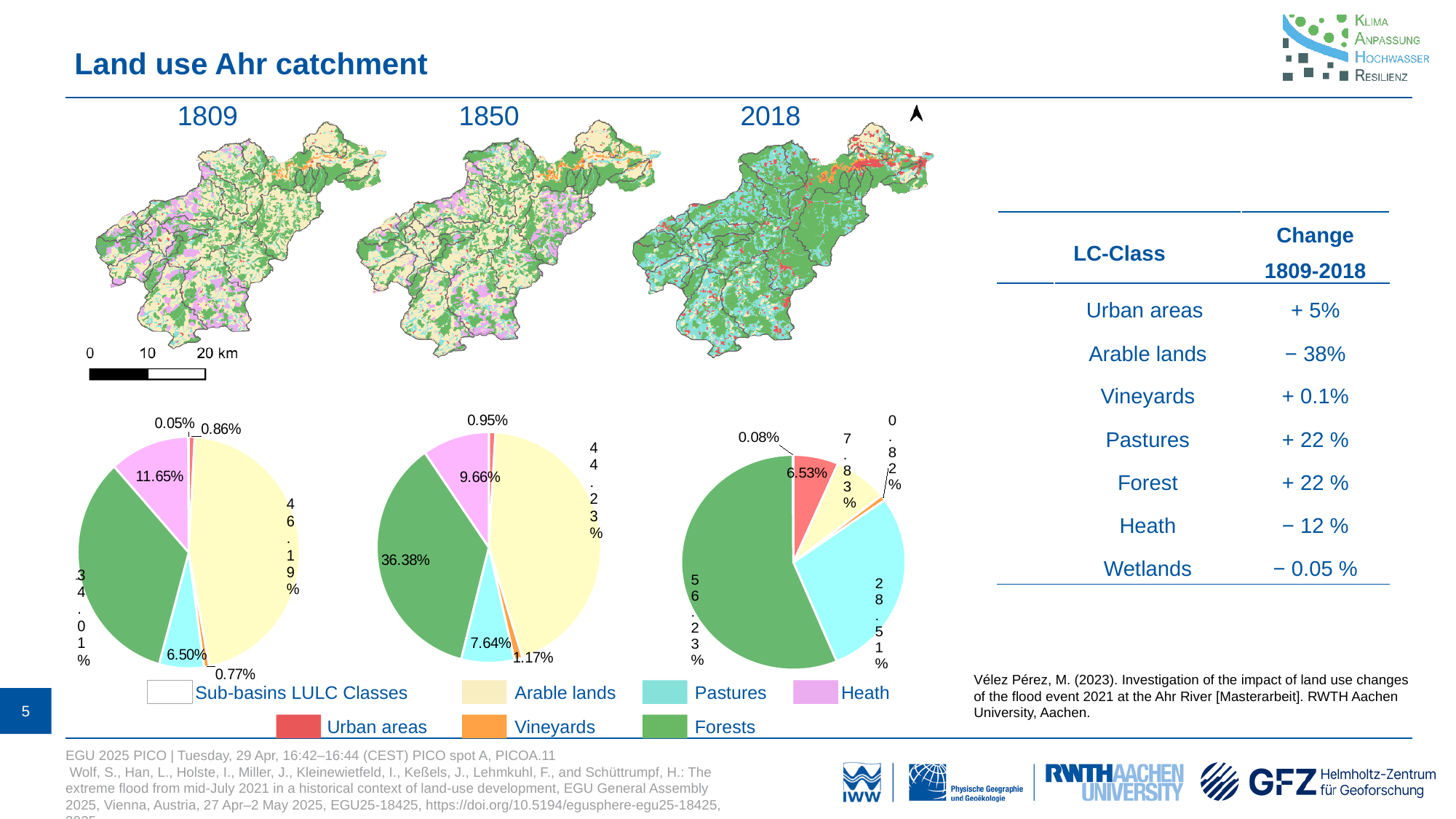
In the 2018 pie chart, what share is Urban areas? 6.53% In the 2018 pie chart, which class has the largest share? Forests In the 1809 pie chart, which class has the largest share? Arable lands In the 1850 pie chart, what share is Heath? 9.66% In the 1850 pie chart, which is larger: Forests or Arable lands? Arable lands In the 1809 pie chart, what share is Forests? 34.01% In the 2018 pie chart, what is the difference between the Forests share and the Pastures share? 27.72% How many pie charts are on the slide? 3 In the 1809 pie chart, what share is Arable lands? 46.19% In the 2018 pie chart, what share is Pastures? 28.51% What kind of charts are shown at the bottom of the slide? Pie charts Across the 1809, 1850 and 2018 pie charts, does the Forests share rise or fall over time? Rise